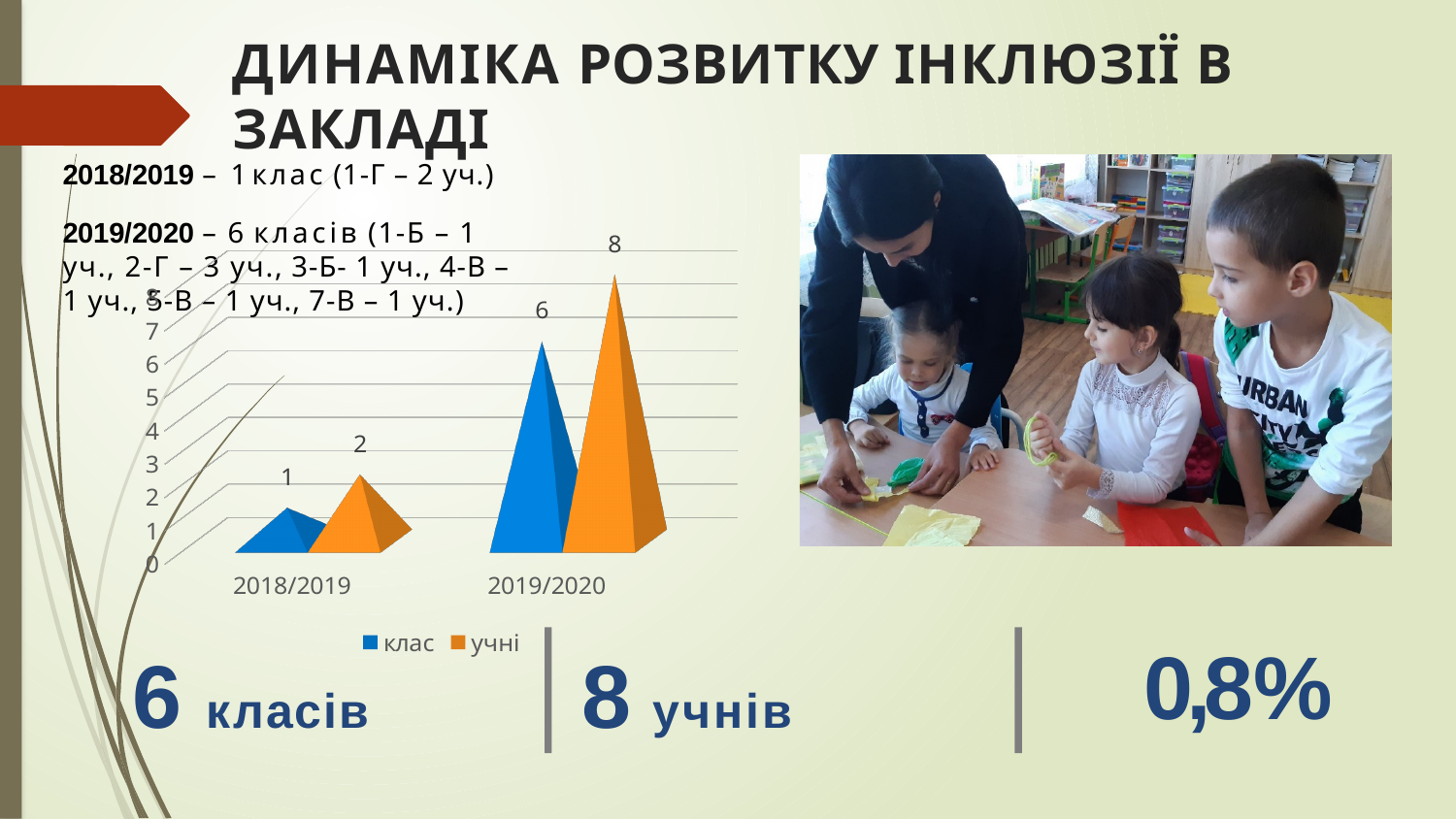
What is the value for "учні" in 2019/2020? 8 What is the value for "клас" in 2019/2020? 6 Which category has the highest value for "учні"? 2019/2020 What is the value for "учні" in 2018/2019? 2 What is the value for "клас" in 2018/2019? 1 How many categories are shown on the x axis? 2 Do the "клас" values rise or fall from 2018/2019 to 2019/2020? rise What is the difference between the "учні" values for 2019/2020 and 2018/2019? 6 Which category has the lowest value for "клас"? 2018/2019 How many series does the legend list? 2 What kind of chart is shown on the slide? bar chart Which is larger in 2019/2020: "клас" or "учні"? учні